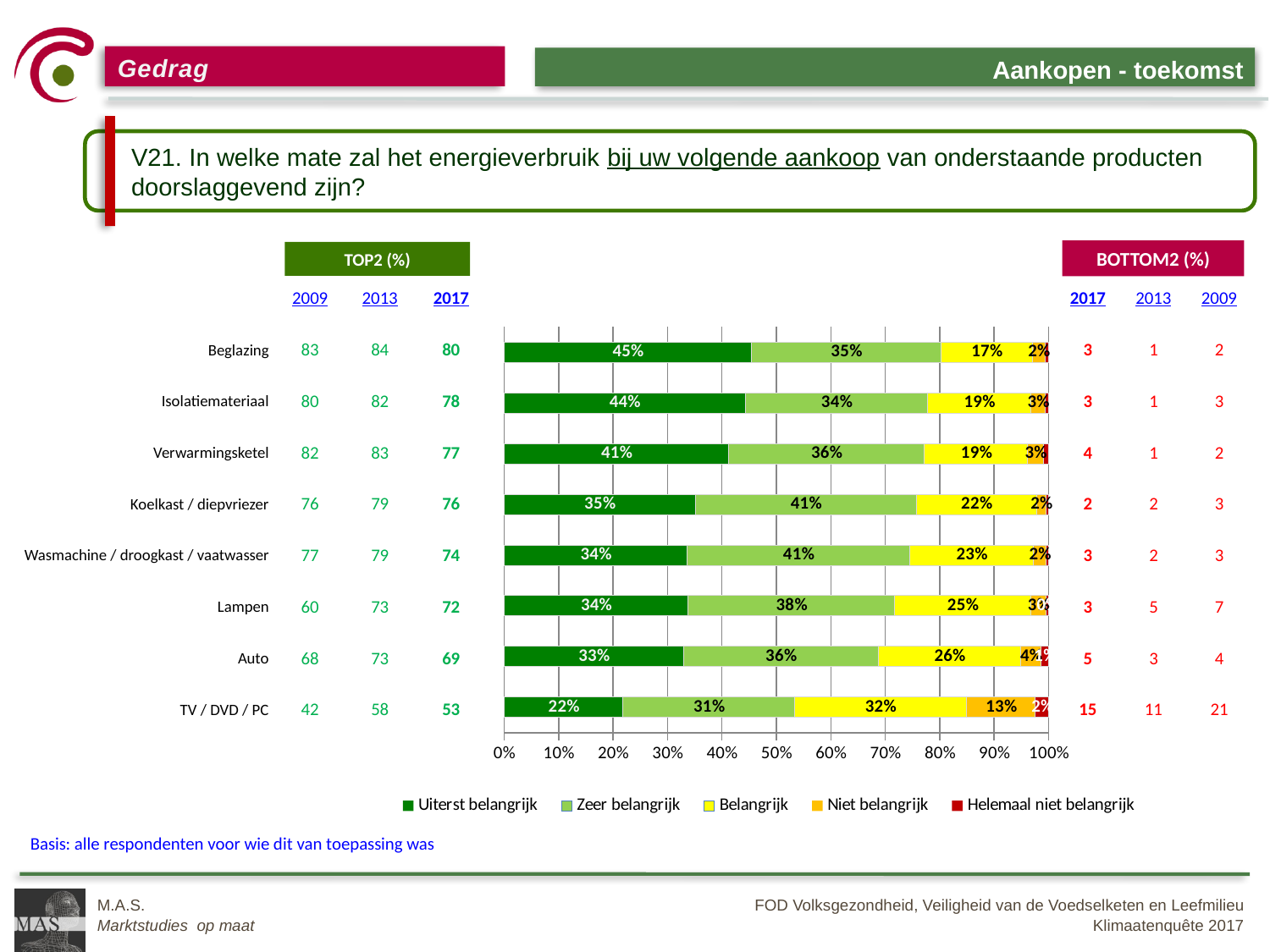
Which colour represents 'Uiterst belangrijk' in the chart? Dark green How many products are shown in the chart? 8 What percentage of respondents rated energy consumption as 'Uiterst belangrijk' for Beglazing? 45% Which product has the highest 'Belangrijk' share? TV / DVD / PC What is the 'Belangrijk' value for TV / DVD / PC? 32% Which has a larger 'Belangrijk' share: Auto or Beglazing? Auto What is the 'Niet belangrijk' value for TV / DVD / PC? 13% Which product has the highest 'Uiterst belangrijk' share? Beglazing Which product has the lowest 'Uiterst belangrijk' share? TV / DVD / PC How many series does the legend list? 5 What is the difference in the 'Zeer belangrijk' share between Koelkast / diepvriezer and Beglazing? 6 percentage points What type of chart is shown on the slide? Stacked bar chart